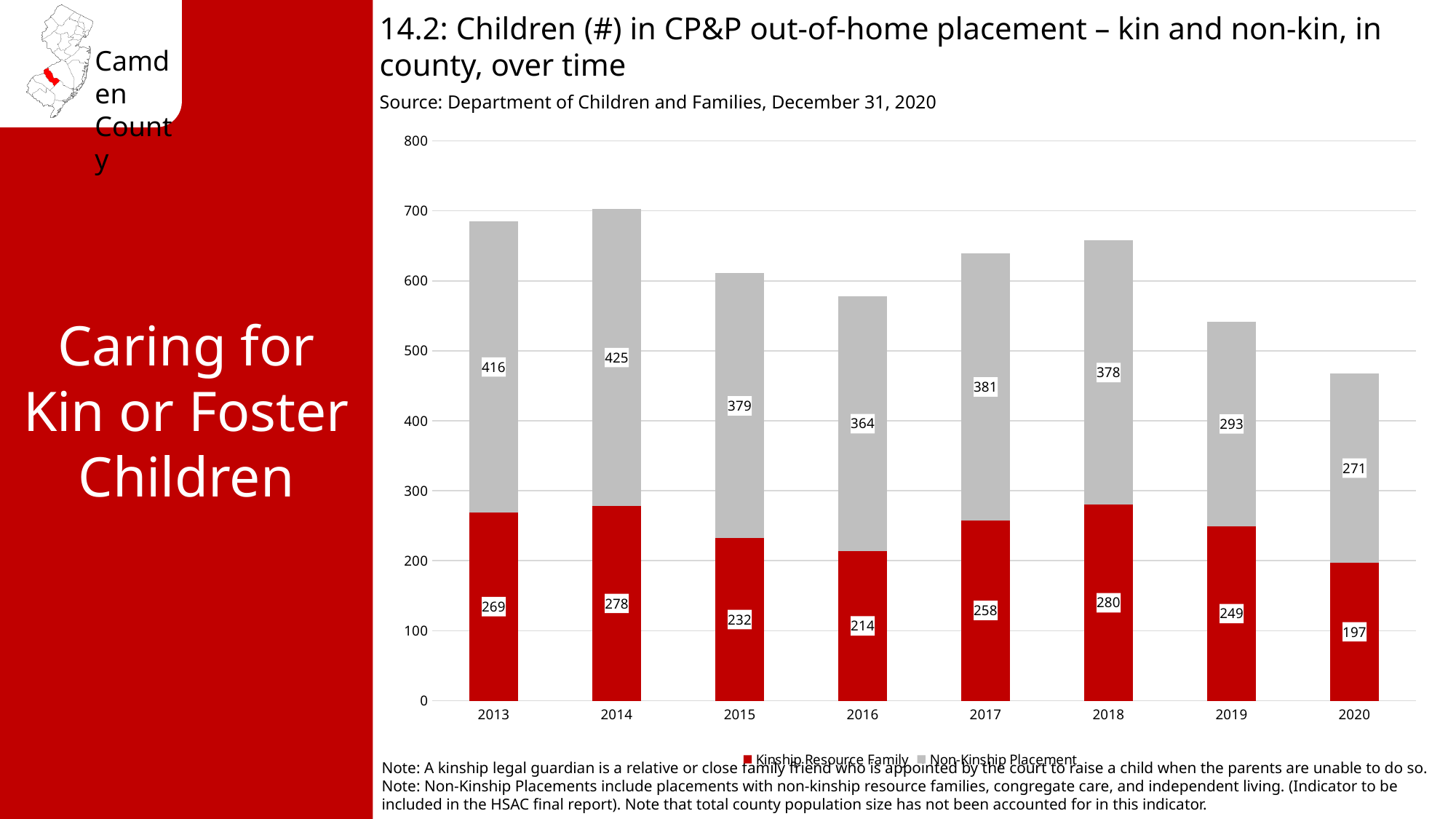
What is the difference between the Non-Kinship Placement values for 2013 and 2019? 123 What is the Kinship Resource Family value for 2020? 197 Which is larger, the Kinship Resource Family value for 2015 or for 2017? 2017 What kind of chart is shown on the slide? Stacked bar chart What is the Non-Kinship Placement value for 2014? 425 Which year has the lowest Non-Kinship Placement value? 2020 How many years are shown on the x axis? 8 What is the Kinship Resource Family value for 2016? 214 Which year has the highest Kinship Resource Family value? 2018 What is the total of the stacked bar for 2020? 468 Is the total height of the 2014 stacked bar greater or less than 700? greater How many series does the legend list? 2